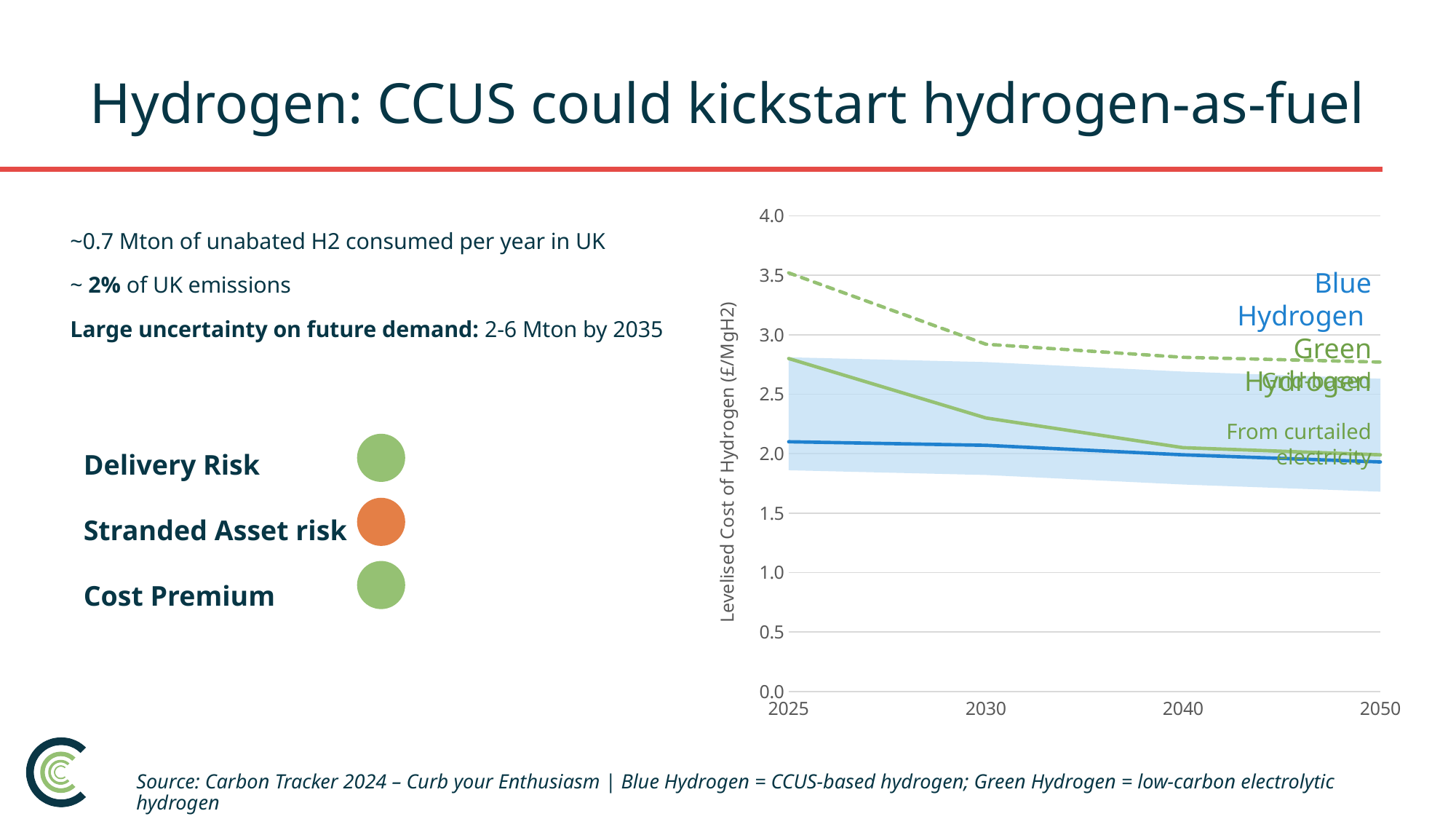
Does the Blue Hydrogen line rise or fall from 2025 to 2050? Fall Does the solid Green Hydrogen line rise or fall from 2025 to 2050? Fall Which series has the highest levelised cost in 2025? Green Hydrogen (dashed line) How many lines (series) are plotted on the chart? 3 What is the label on the y-axis of the chart? Levelised Cost of Hydrogen (£/MgH2) Which series has the lowest levelised cost in 2025? Blue Hydrogen What kind of chart is shown on the slide? Line chart Is the value of the Blue Hydrogen line in 2025 greater or less than 2.5? less In 2025, which is higher: the Blue Hydrogen line or the solid Green Hydrogen line? Green Hydrogen How many years are labelled on the x-axis of the chart? 4 Is the value of the solid Green Hydrogen line in 2040 greater or less than 2.5? less